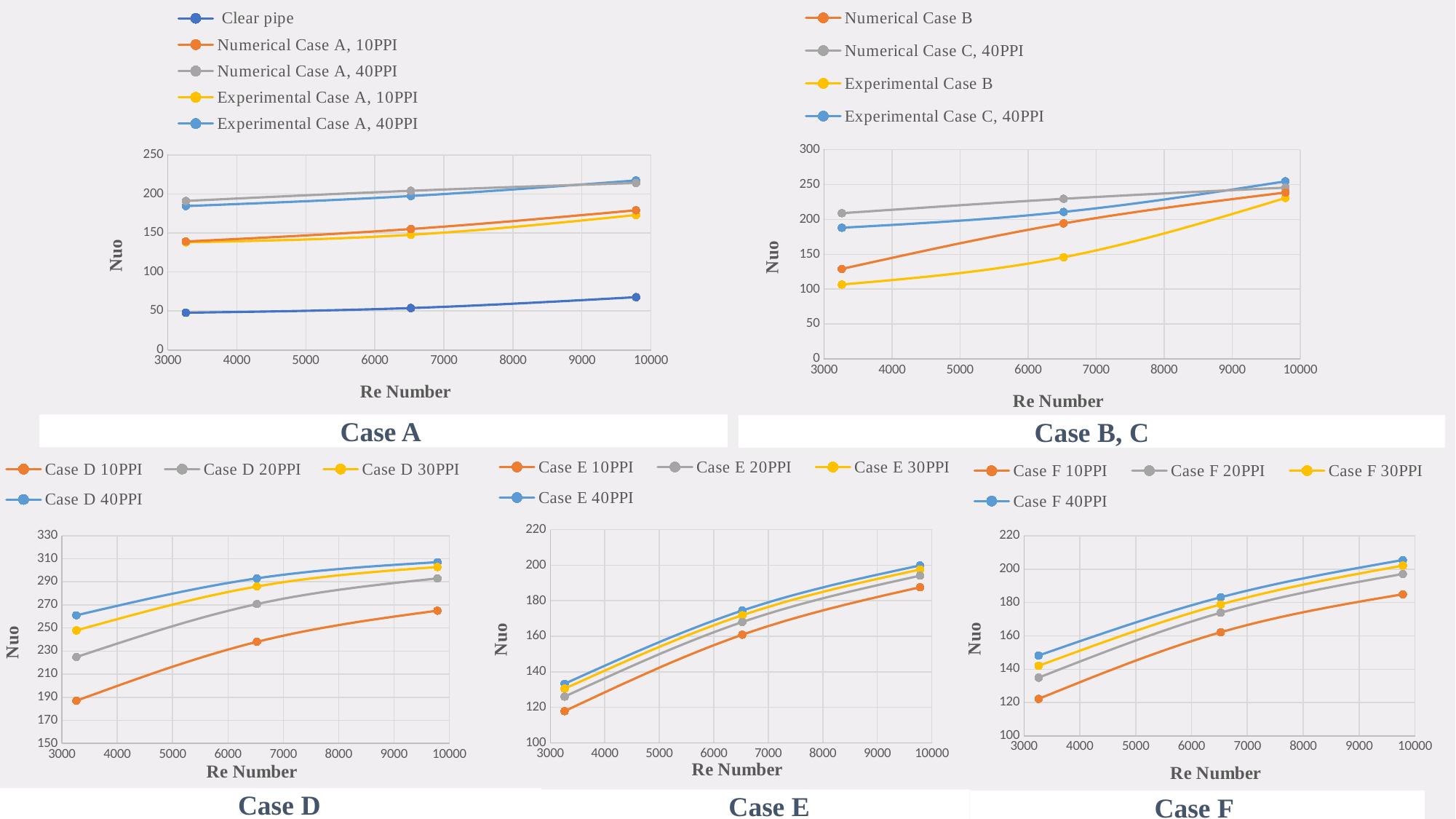
In the Case D chart, how many data points does each series have? 3 In the Case B, C chart, is the Nuo value for Numerical Case C, 40PPI at the smallest Re Number greater or less than 200? greater In the Case F chart, which is larger at the largest Re Number: the Nuo value for Case F 40PPI or Case F 10PPI? Case F 40PPI In the Case B, C chart, which series has the lowest Nuo value at the smallest Re Number? Experimental Case B In the Case B, C chart, how many series does the legend list? 4 In the Case A chart, which series has the lowest Nuo values across all Re numbers? Clear pipe What is the label of the x axis on the Case E chart? Re Number In the Case A chart, how many series does the legend list? 5 In the Case A chart, do the Nuo values for Clear pipe rise or fall as the Re Number increases? rise In the Case D chart, which series has the highest Nuo values? Case D 40PPI What kind of chart is the Case D chart? line chart